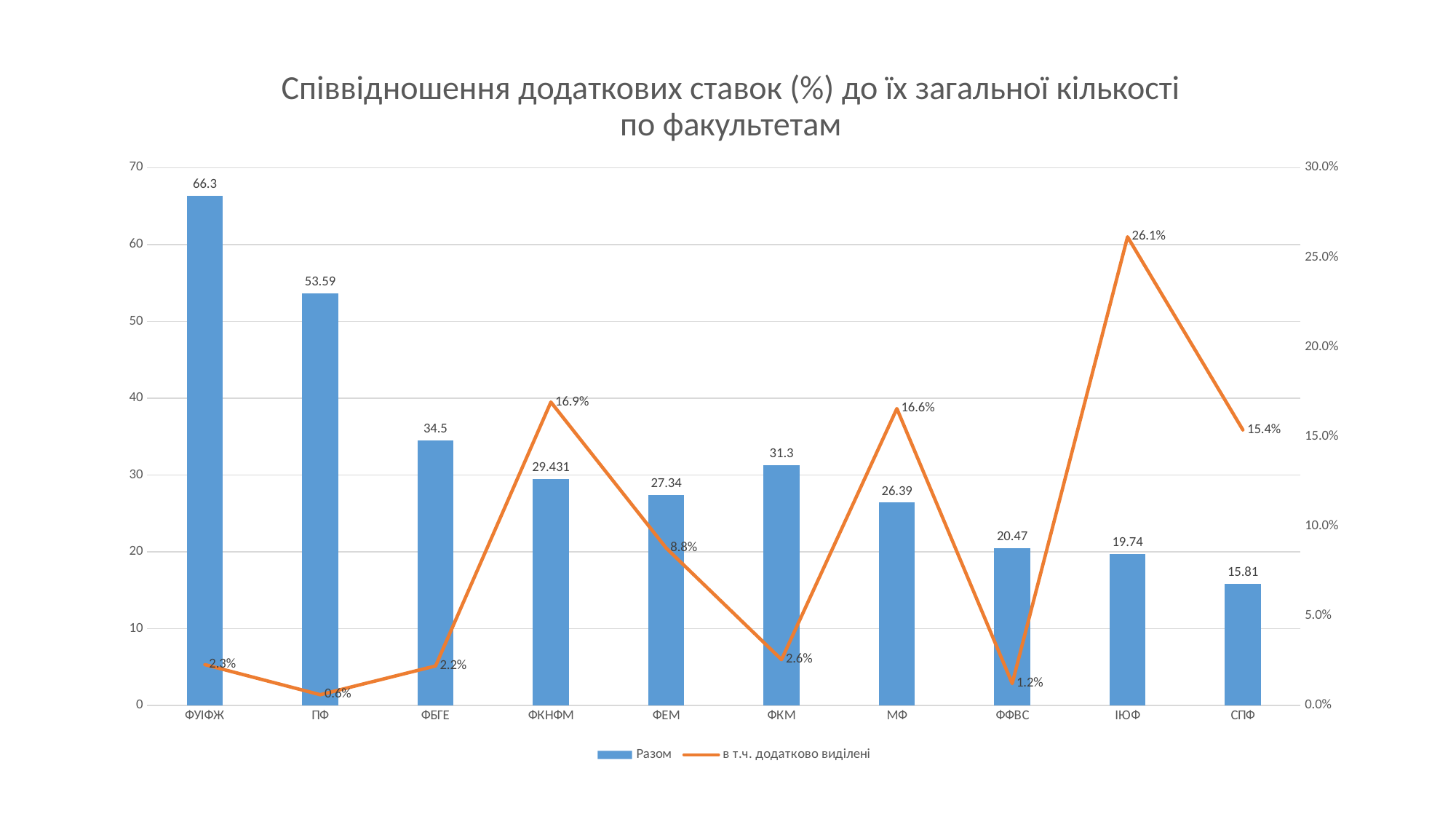
Which is larger, the "Разом" value for ФКМ or for ФЕМ? ФКМ Which faculty has the lowest "в т.ч. додатково виділені" value? ПФ What is the "Разом" value for ФКНФМ? 29.431 What is the value of the "Разом" bar for ФУІФЖ? 66.3 What is the difference between the "в т.ч. додатково виділені" values for ІЮФ and СПФ? 10.7% What kind of chart is shown on the slide? Combined bar and line chart Which faculty has the lowest "Разом" bar? СПФ How many faculties are shown on the x axis? 10 What is the difference between the "Разом" values for ФУІФЖ and ПФ? 12.71 Which faculty has the highest "Разом" bar? ФУІФЖ What is the "в т.ч. додатково виділені" value for ІЮФ? 26.1% How many series does the legend list? 2